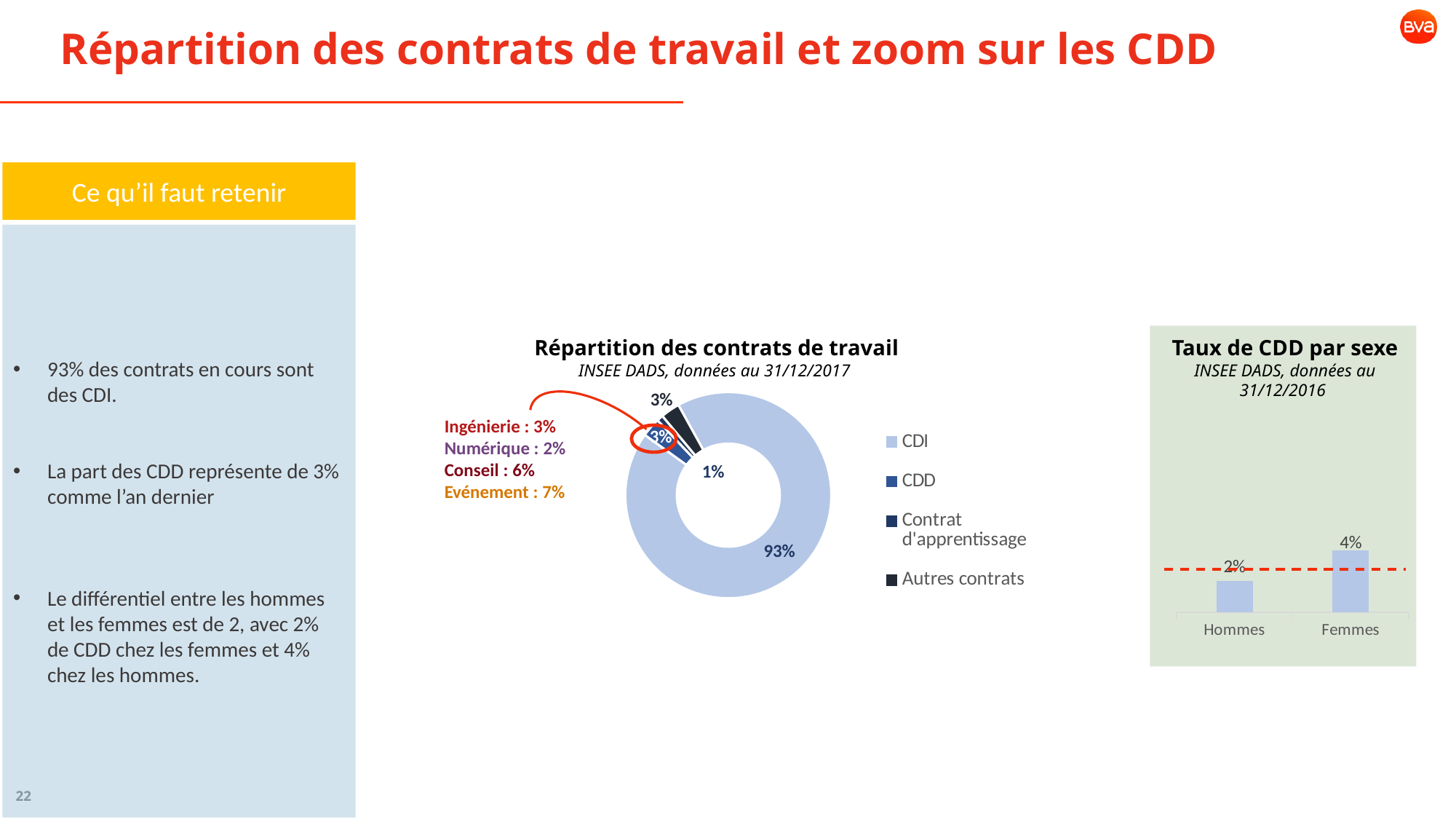
In the 'Taux de CDD par sexe' chart, which category has the higher value, Hommes or Femmes? Femmes In the 'Taux de CDD par sexe' chart, what is the value for Hommes? 2% In the 'Taux de CDD par sexe' chart, what is the difference between the values for Femmes and Hommes? 2% In the 'Taux de CDD par sexe' chart, what is the value for Femmes? 4% What data source and date are cited under the title of the 'Taux de CDD par sexe' chart? INSEE DADS, données au 31/12/2016 In the 'Répartition des contrats de travail' chart, what share of contracts are CDD? 3% In the 'Répartition des contrats de travail' chart, what share of contracts are CDI? 93% In the 'Répartition des contrats de travail' chart, which contract type has the largest share? CDI What kind of chart is 'Taux de CDD par sexe'? Bar chart What kind of chart is 'Répartition des contrats de travail'? Donut (pie) chart How many entries does the legend of the 'Répartition des contrats de travail' chart list? 4 How many categories are shown in the 'Taux de CDD par sexe' chart? 2